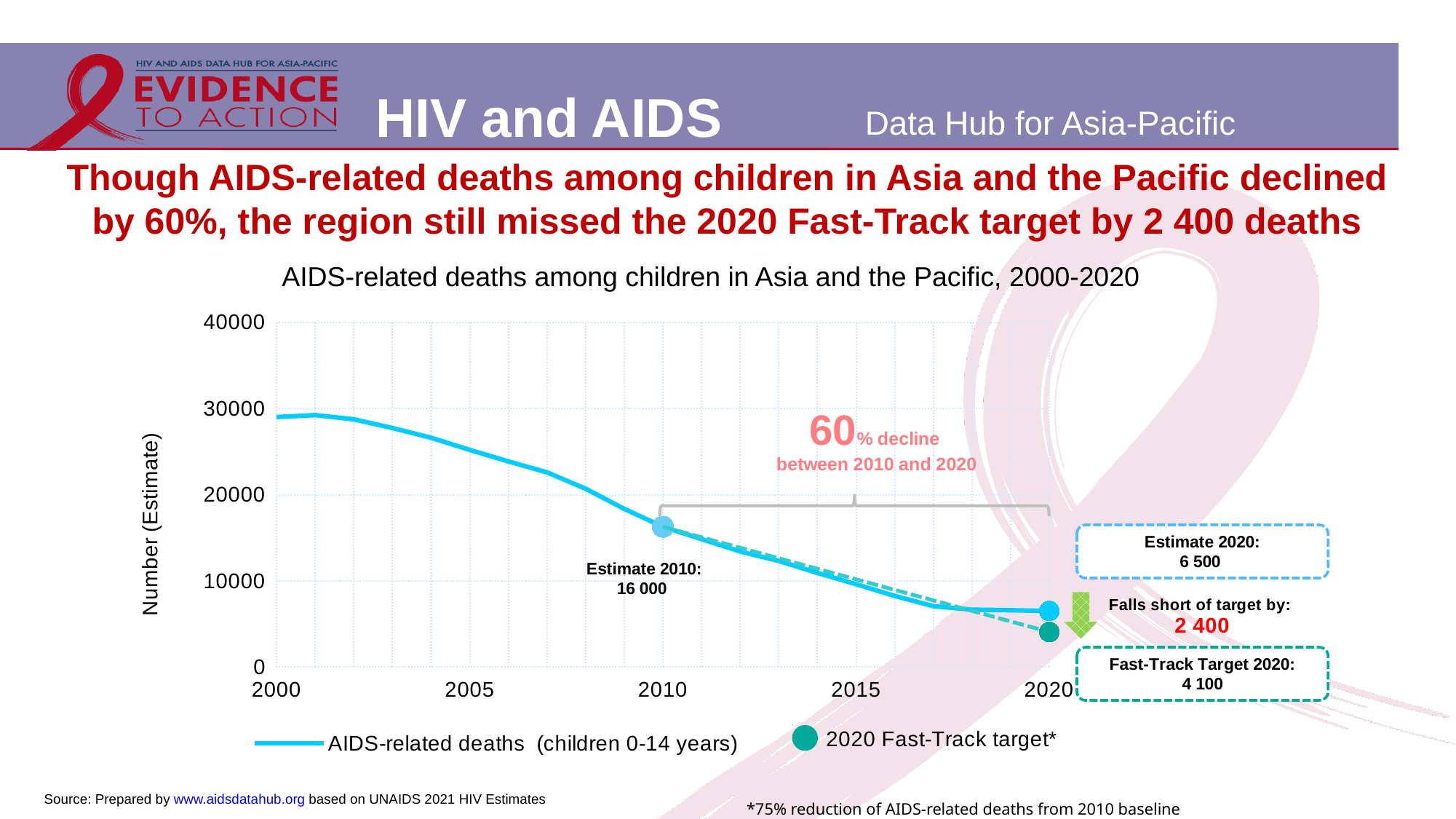
What is the estimated number of AIDS-related deaths among children in 2020? 6 500 What is the 2020 Fast-Track target for AIDS-related deaths among children? 4 100 Is the value for AIDS-related deaths among children in 2000 greater or less than 20000? greater What is the difference between the 2010 estimate and the 2020 estimate of AIDS-related deaths among children? 9 500 Which is larger, the 2020 estimate or the 2020 Fast-Track target? 2020 estimate What kind of chart is used to show AIDS-related deaths among children in Asia and the Pacific? line chart What is the estimated number of AIDS-related deaths among children in 2010? 16 000 Do AIDS-related deaths among children rise or fall from 2000 to 2020? fall What percentage decline in AIDS-related deaths among children occurred between 2010 and 2020? 60% By how many deaths does the 2020 estimate fall short of the 2020 Fast-Track target? 2 400 What is the title of the chart? AIDS-related deaths among children in Asia and the Pacific, 2000-2020